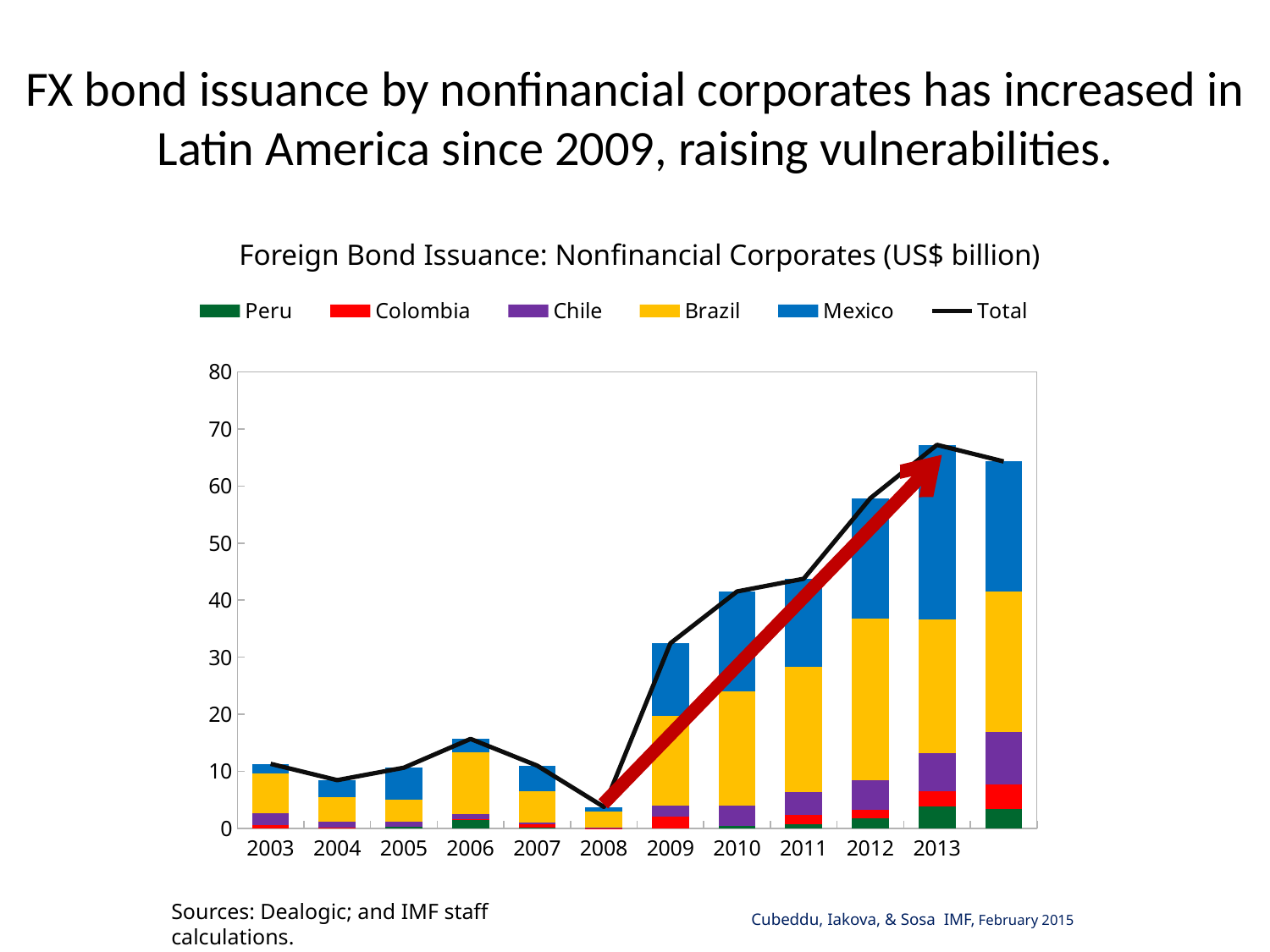
Is the total value for 2006 greater or less than 10? greater Is the total value for 2013 greater or less than 60? greater What is the title of the chart? Foreign Bond Issuance: Nonfinancial Corporates (US$ billion) Which year has a larger total, 2008 or 2009? 2009 How many series does the legend list? 6 Is the total value for 2009 greater or less than 30? greater Which labeled year has the highest total foreign bond issuance? 2013 Do the total values rise or fall from 2009 to 2013? rise What kind of chart is shown on the slide? Stacked bar chart with a line Which labeled year has the lowest total foreign bond issuance? 2008